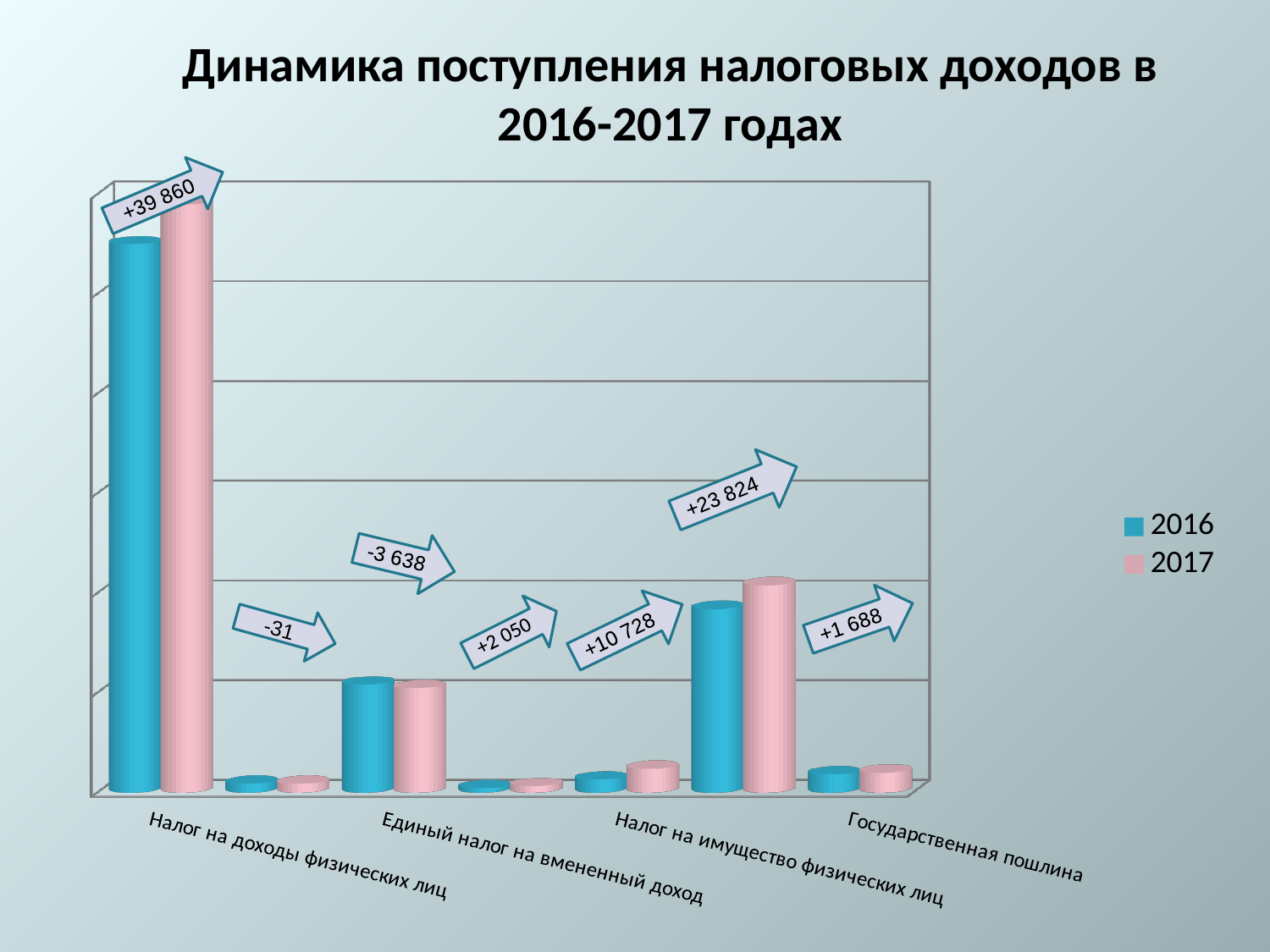
How many of the arrow annotations show a negative change? 2 How many pairs of bars (category groups) are plotted in the chart? 7 How many arrow annotations with change values are shown on the chart? 7 What is the largest change value printed on the arrows in the chart? +39 860 Which category has the tallest bars in the chart? Налог на доходы физических лиц What is the title of the chart? Динамика поступления налоговых доходов в 2016-2017 годах What change value is printed on the arrow above Налог на доходы физических лиц? +39 860 What kind of chart is shown on the slide? bar chart What is the lowest (most negative) change value printed on the arrows in the chart? -3 638 How many series does the legend list? 2 What are the two series named in the legend? 2016 and 2017 For Налог на доходы физических лиц, which bar is taller, 2016 or 2017? 2017